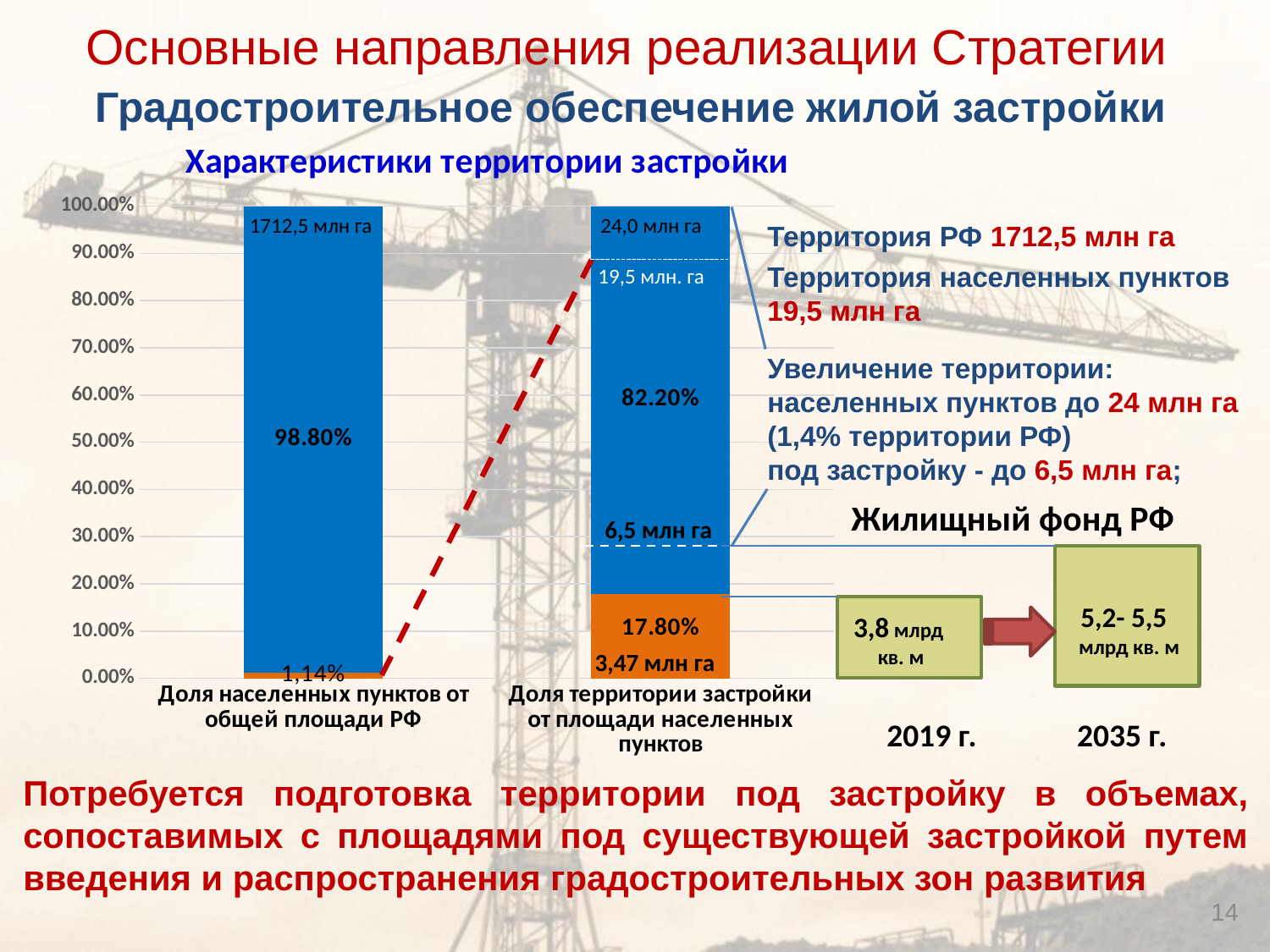
What is the value of the orange segment in the bar "Доля территории застройки от площади населенных пунктов"? 17.80% Is the orange segment of the bar "Доля территории застройки от площади населенных пунктов" greater or less than 20.00%? less What type of chart is shown under the title "Характеристики территории застройки"? bar chart What area label appears at the top of the bar "Доля населенных пунктов от общей площади РФ"? 1712,5 млн га What is the difference between the blue segment values of the two bars (98.80% and 82.20%)? 16.60% What is the title of the chart on the slide? Характеристики территории застройки What is the value of the blue segment in the bar "Доля населенных пунктов от общей площади РФ"? 98.80% What is the value of the blue segment in the bar "Доля территории застройки от площади населенных пунктов"? 82.20% Which bar has the larger orange segment: "Доля населенных пунктов от общей площади РФ" or "Доля территории застройки от площади населенных пунктов"? Доля территории застройки от площади населенных пунктов How many bars (categories) does the chart show? 2 What is the value of the orange segment in the bar "Доля населенных пунктов от общей площади РФ"? 1,14% What area in million hectares is labelled on the orange segment of the bar "Доля территории застройки от площади населенных пунктов"? 3,47 млн га